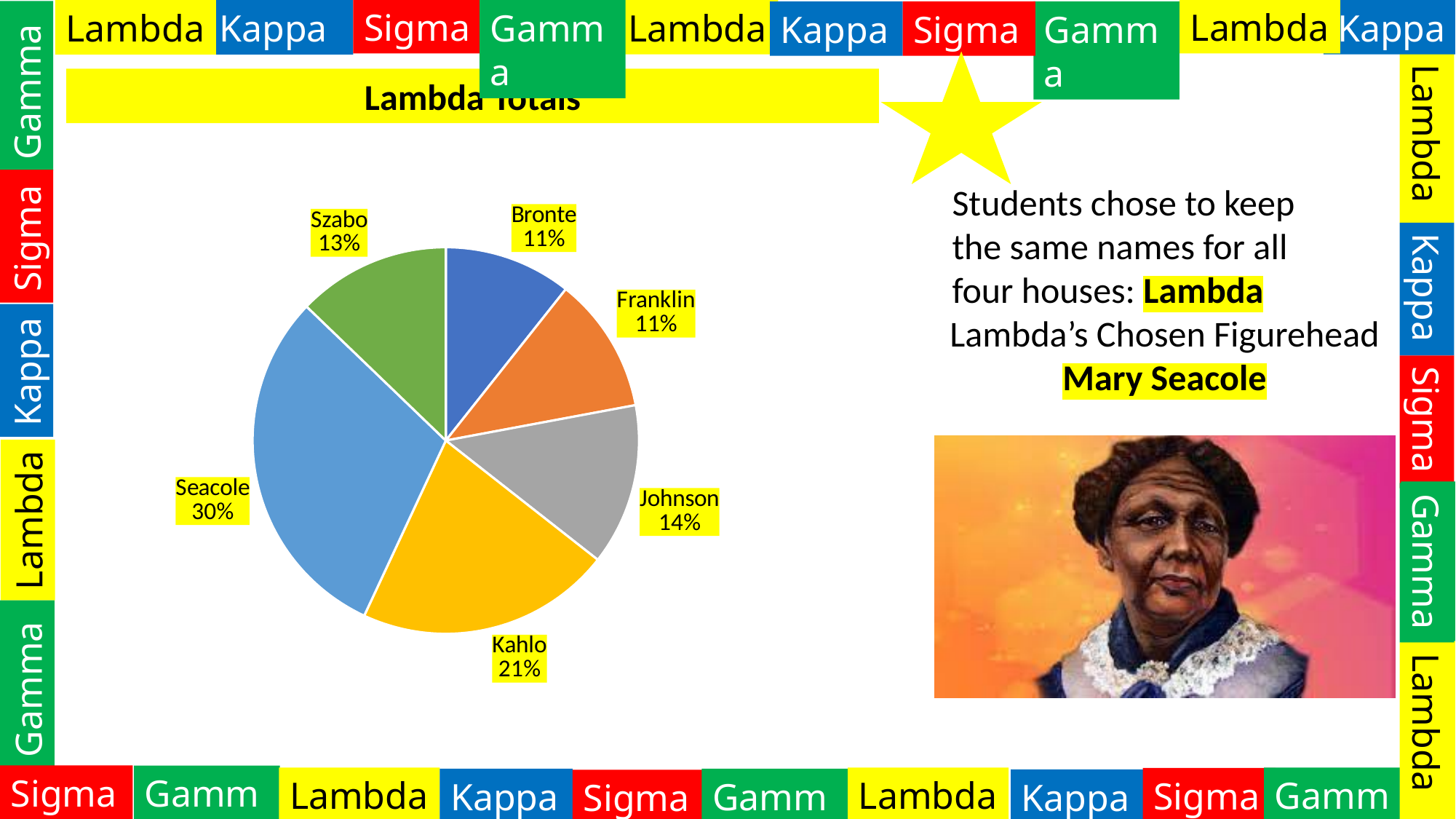
Which two categories share the same percentage of 11%? Bronte and Franklin What is the value shown for Szabo? 13% How many slices does the pie chart have? 6 What is the difference between the Kahlo and Johnson percentages? 7% What kind of chart is shown on the slide? pie chart What share of the pie does Kahlo have? 21% Which is larger, the slice for Johnson or the slice for Szabo? Johnson What is the value shown for Johnson? 14% What share of the pie does Seacole have? 30% What colour is the Seacole slice of the pie? light blue Which category has the largest slice of the pie? Seacole What is the difference between the Seacole and Kahlo percentages? 9%